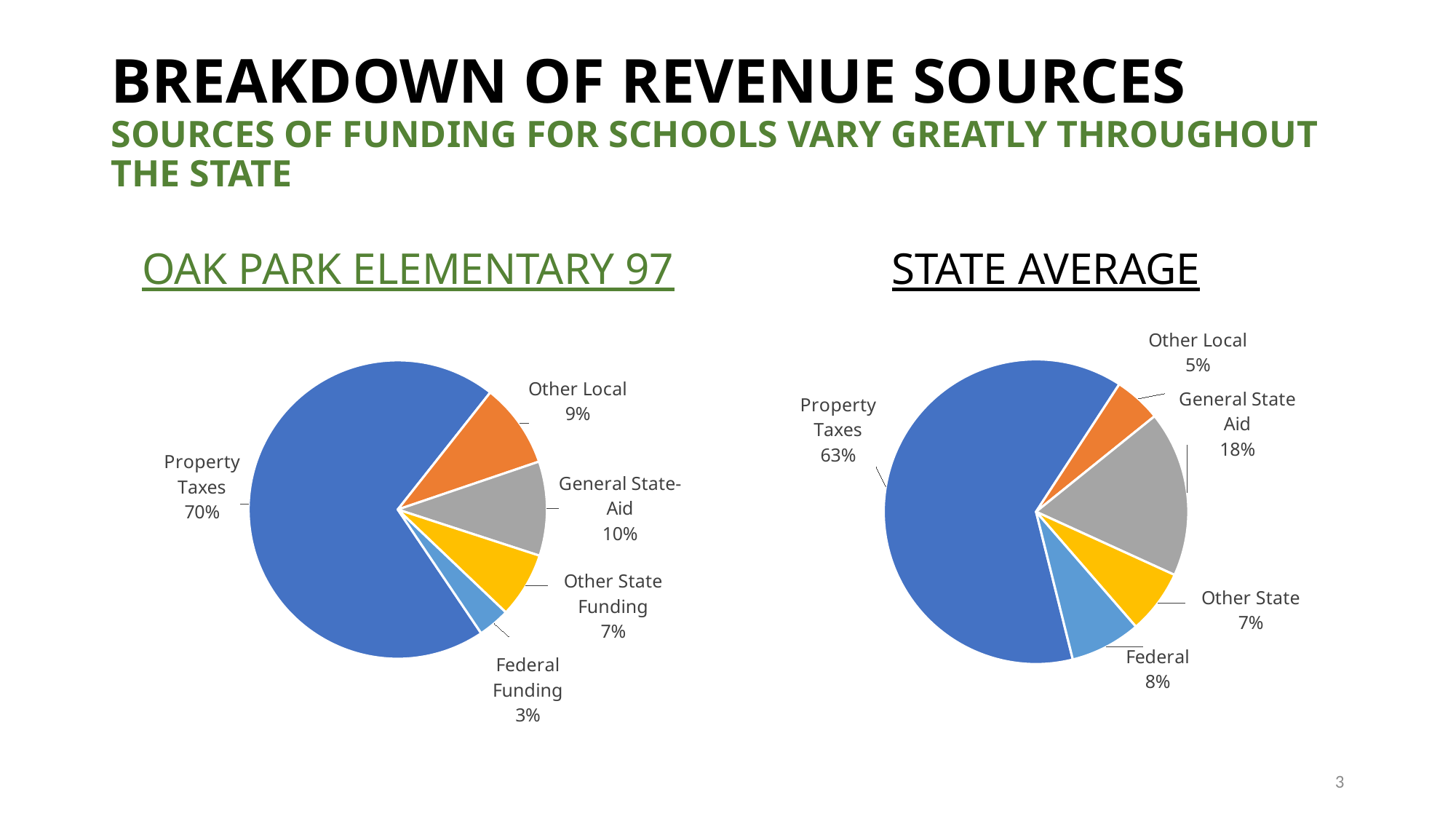
In the State Average chart, what colour is the Federal slice? Light blue Which is larger: General State Aid in the State Average chart or General State-Aid in the Oak Park Elementary 97 chart? State Average In the State Average chart, what is the value for Other Local? 5% What is the difference between the Property Taxes share in the Oak Park Elementary 97 chart and in the State Average chart? 7% In the Oak Park Elementary 97 chart, which revenue source has the smallest share? Federal Funding In the State Average chart, what share of revenue comes from General State Aid? 18% How many slices does the Oak Park Elementary 97 chart have? 5 In the Oak Park Elementary 97 chart, what is the value for Federal Funding? 3% In the Oak Park Elementary 97 chart, what share of revenue comes from Property Taxes? 70% In the State Average chart, which revenue source has the smallest share? Other Local What type of chart is the State Average chart? Pie chart In the Oak Park Elementary 97 chart, which revenue source has the largest share? Property Taxes